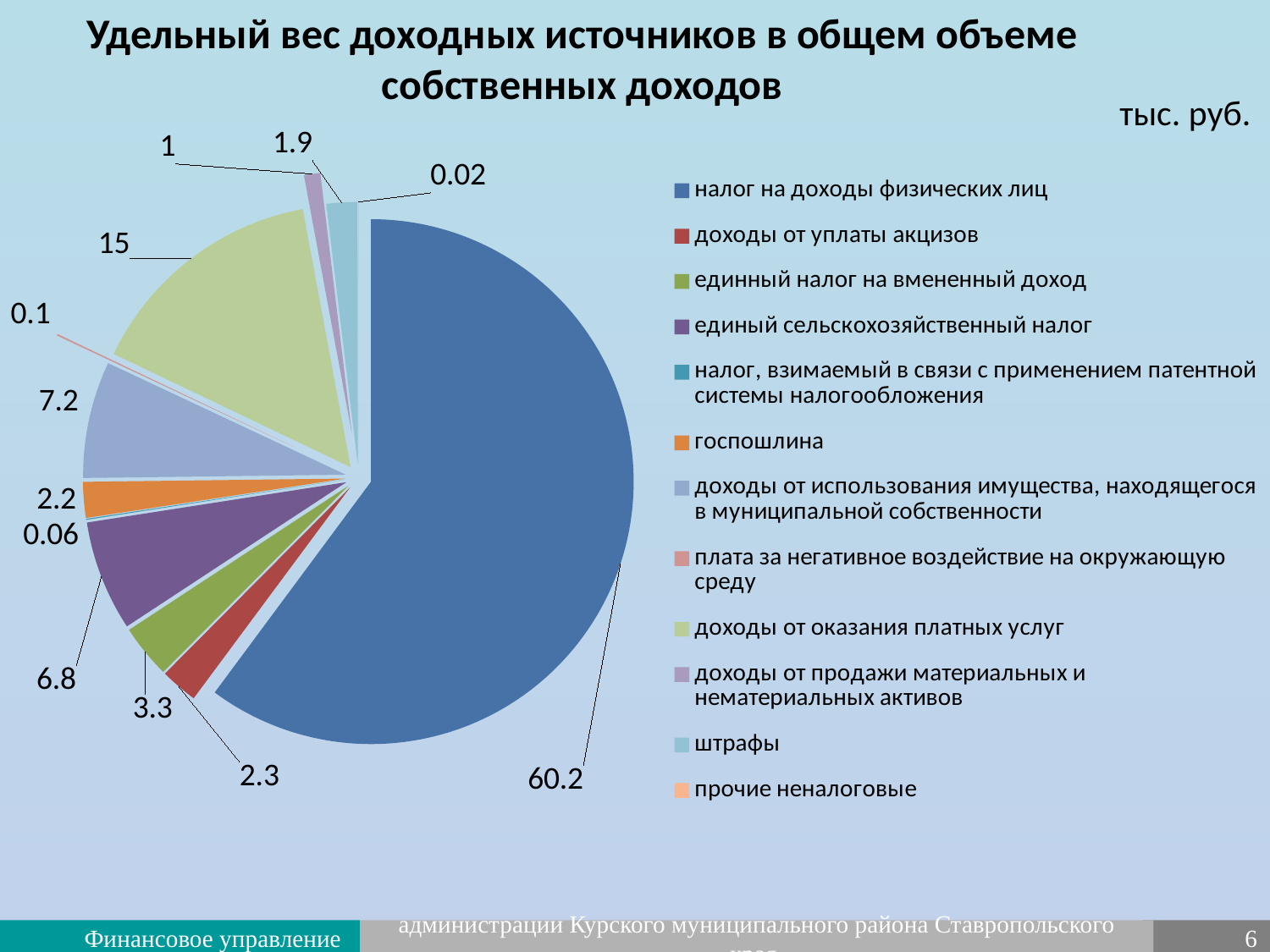
What is the value for единый сельскохозяйственный налог? 6.8 What is the value for штрафы? 1.9 What is the value for доходы от использования имущества, находящегося в муниципальной собственности? 7.2 Which category has the largest slice of the pie? налог на доходы физических лиц What is the value for налог на доходы физических лиц? 60.2 What is the difference between the values for доходы от оказания платных услуг and единый сельскохозяйственный налог? 8.2 Which is larger: the value for единный налог на вмененный доход or the value for доходы от уплаты акцизов? единный налог на вмененный доход What unit is indicated in the top right corner of the slide? тыс. руб. What type of chart is shown on the slide? pie chart How many categories does the legend list? 12 Which category has the smallest slice of the pie? прочие неналоговые What is the value for доходы от оказания платных услуг? 15